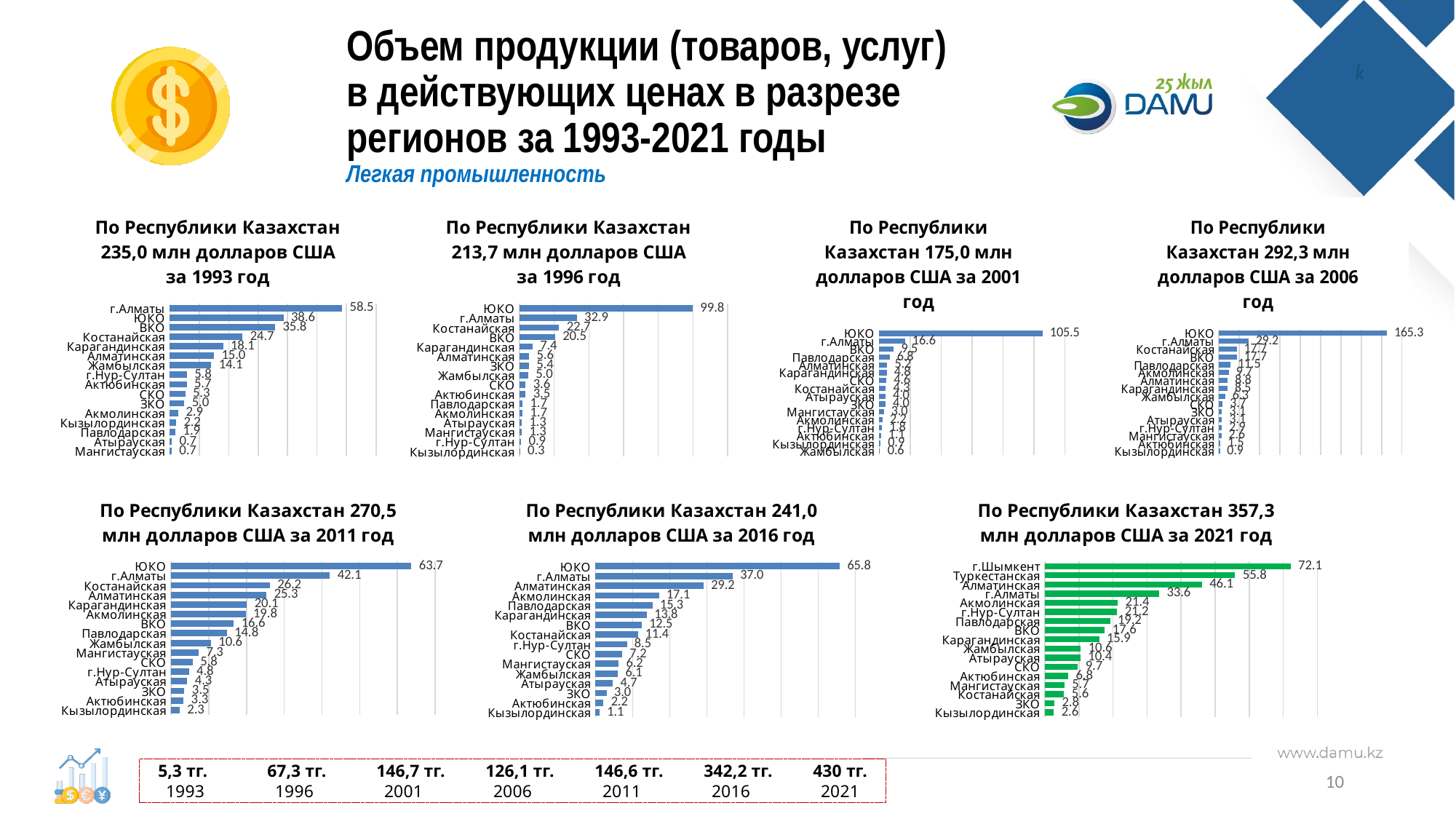
What type of chart is used for the 2021 data (По Республики Казахстан 357,3 млн долларов США за 2021 год)? Bar chart In the chart for 2011, what is the value for Алматинская? 25.3 In the chart for 1993 (По Республики Казахстан 235,0 млн долларов США за 1993 год), what is the value for г.Алматы? 58.5 In the chart for 2011, which region has the lowest value? Кызылординская In the chart for 1996, which region has the highest value? ЮКО In the chart for 2016, which is larger: г.Алматы or Алматинская? г.Алматы In the chart for 2021, what is the difference between г.Шымкент and Туркестанская? 16.3 In the chart for 2006, what is the difference between ЮКО and г.Алматы? 136.1 In the chart for 2021, which region has the highest value? г.Шымкент In the chart for 2001, what is the value for ЮКО? 105.5 In the chart for 1996, what is the value for Костанайская? 22.7 In the chart for 2016, what is the value for Акмолинская? 17.1